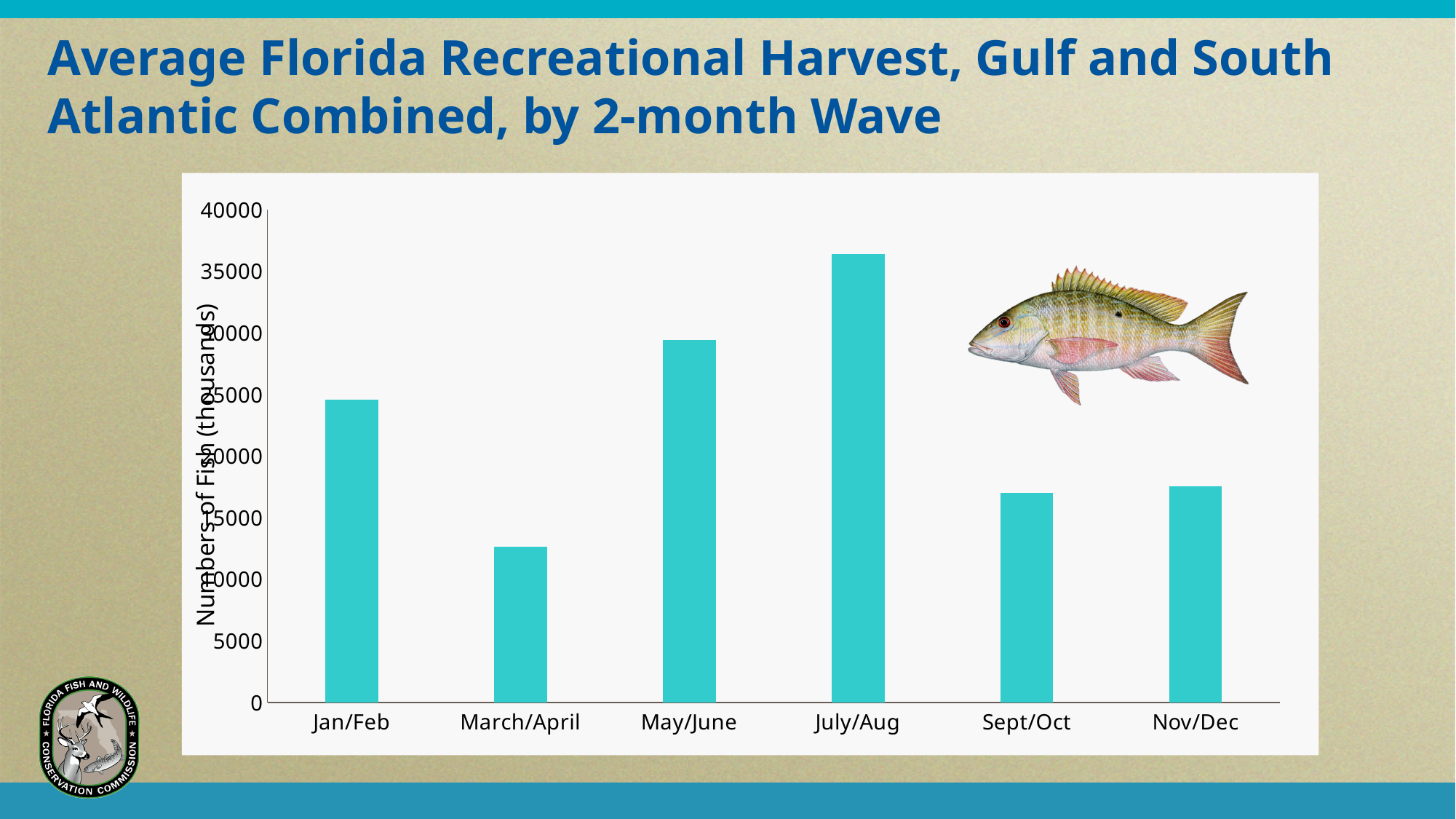
Is the value for Sept/Oct greater or less than 20000? less Is the value for July/Aug greater or less than 35000? greater What is the label on the y axis of the chart? Numbers of Fish (thousands) Is the value for Jan/Feb greater or less than 20000? greater Which is larger, the value for Jan/Feb or the value for March/April? Jan/Feb What kind of chart is shown on the slide? bar chart Which 2-month wave has the highest average harvest? July/Aug Which is larger, the value for May/June or the value for Sept/Oct? May/June How many 2-month waves are shown on the x axis? 6 Which 2-month wave has the lowest average harvest? March/April